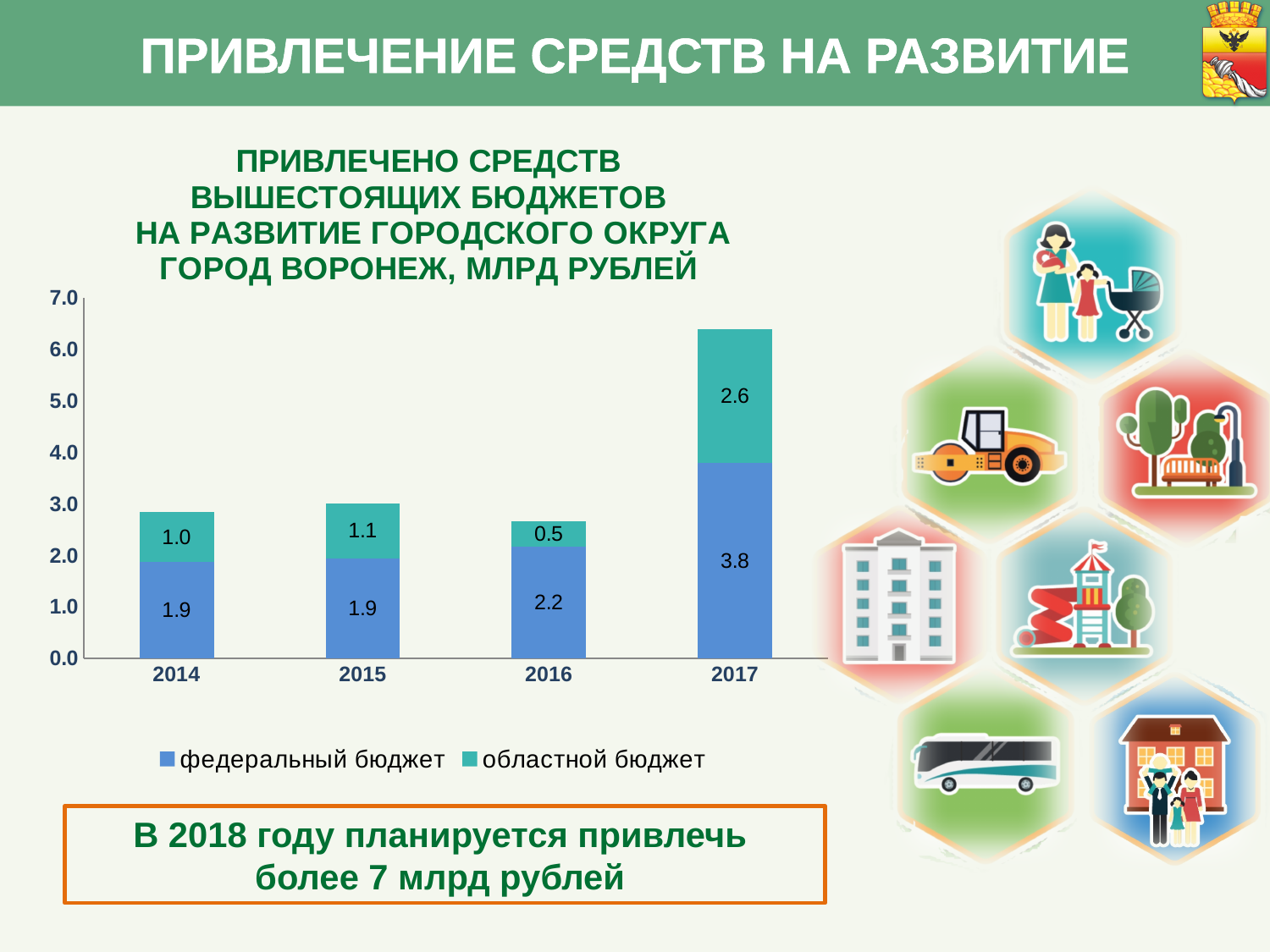
Which year has the highest value for областной бюджет? 2017 What is the value for областной бюджет in 2014? 1.0 What is the difference between the федеральный бюджет values for 2017 and 2016? 1.6 What is the value for федеральный бюджет in 2017? 3.8 What is the value for областной бюджет in 2016? 0.5 Which is larger: федеральный бюджет in 2016 or федеральный бюджет in 2015? федеральный бюджет in 2016 Which year has the lowest value for областной бюджет? 2016 What is the total of the stacked bar for 2017? 6.4 How many series does the legend list? 2 What kind of chart is shown on the slide? stacked bar chart What is the total of the stacked bar for 2015? 3.0 How many years are shown on the x axis? 4